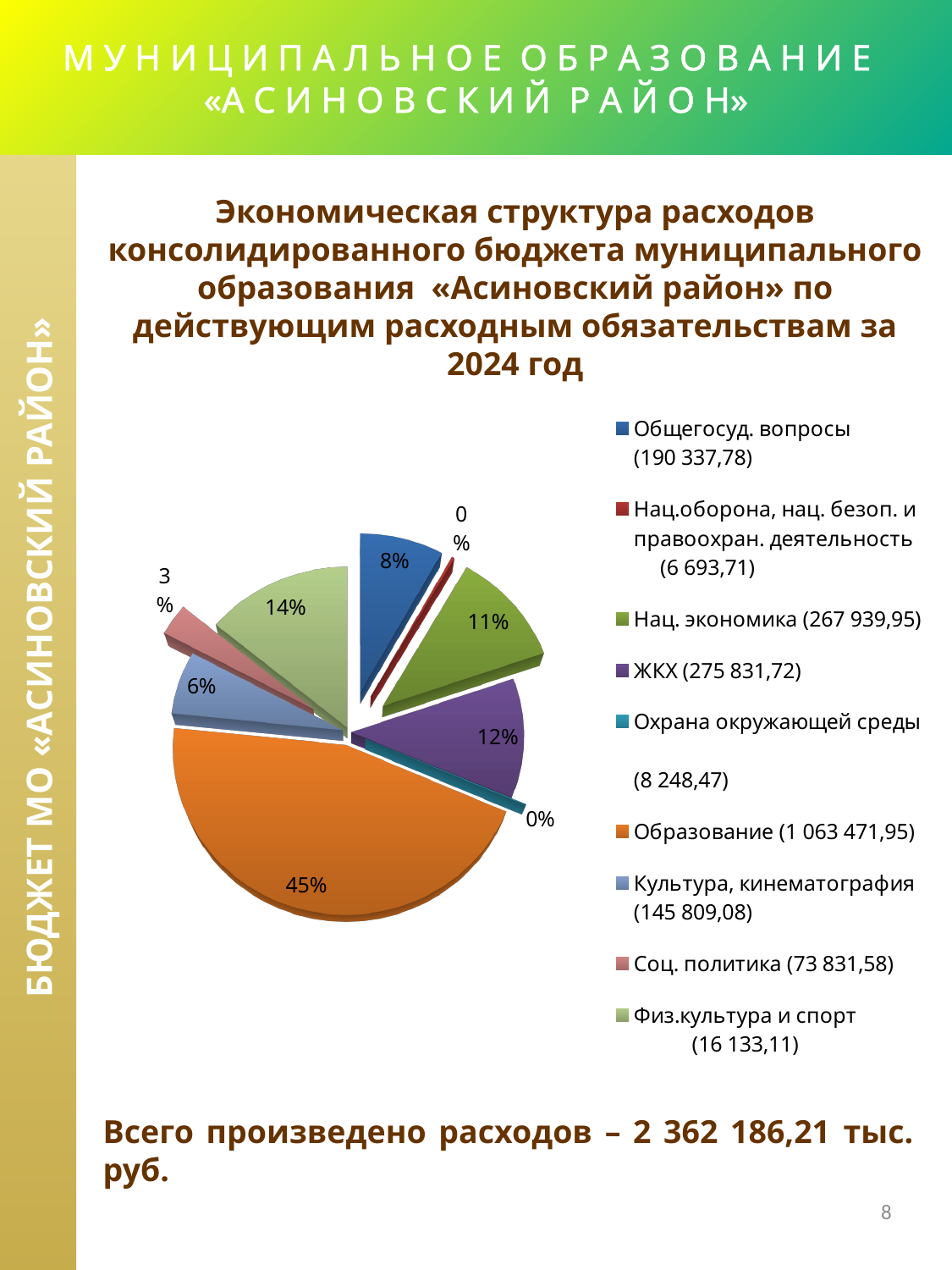
What percentage share does the Общегосуд. вопросы slice have in the pie chart? 8% Which is larger in the pie chart: the share for Нац. экономика or the share for Культура, кинематография? Нац. экономика How many categories does the legend of the pie chart list? 9 What is the difference in percentage points between the Образование slice and the ЖКХ slice? 33 What percentage share does the ЖКХ slice have in the pie chart? 12% What value is shown in the legend for Нац. экономика? 267 939,95 Which category has the largest slice in the pie chart? Образование What percentage share does the Образование slice have in the pie chart? 45% What percentage share does the Физ.культура и спорт slice have in the pie chart? 14% What colour is the Образование slice in the pie chart? orange What value is shown in the legend for Соц. политика? 73 831,58 What kind of chart is shown on the slide? pie chart